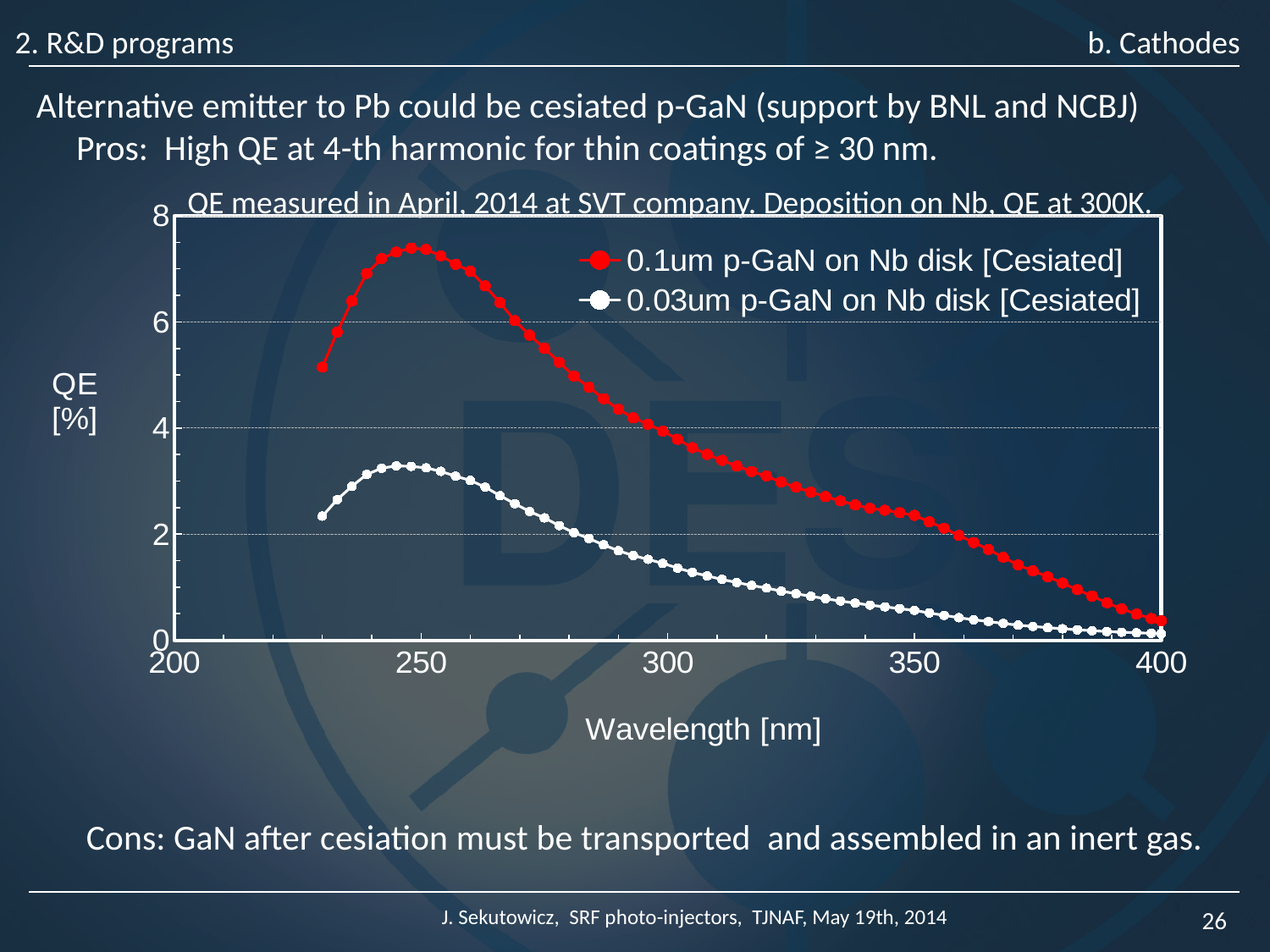
Is the value for the 0.03um p-GaN on Nb disk [Cesiated] series at 250 nm greater or less than 4? less Is the value for the 0.1um p-GaN on Nb disk [Cesiated] series at 400 nm greater or less than 2? less At 300 nm, which series has the higher QE: 0.1um p-GaN on Nb disk [Cesiated] or 0.03um p-GaN on Nb disk [Cesiated]? 0.1um p-GaN on Nb disk [Cesiated] Is the value for the 0.03um p-GaN on Nb disk [Cesiated] series at 300 nm greater or less than 2? less Between 250 nm and 400 nm, do the values of the 0.1um p-GaN on Nb disk [Cesiated] series rise or fall? fall What is the x-axis title of the chart? Wavelength [nm] What kind of chart is shown on the slide? line chart How many series does the chart legend list? 2 Which series reaches the highest QE value in the chart? 0.1um p-GaN on Nb disk [Cesiated] Which series is drawn in red in the chart? 0.1um p-GaN on Nb disk [Cesiated]